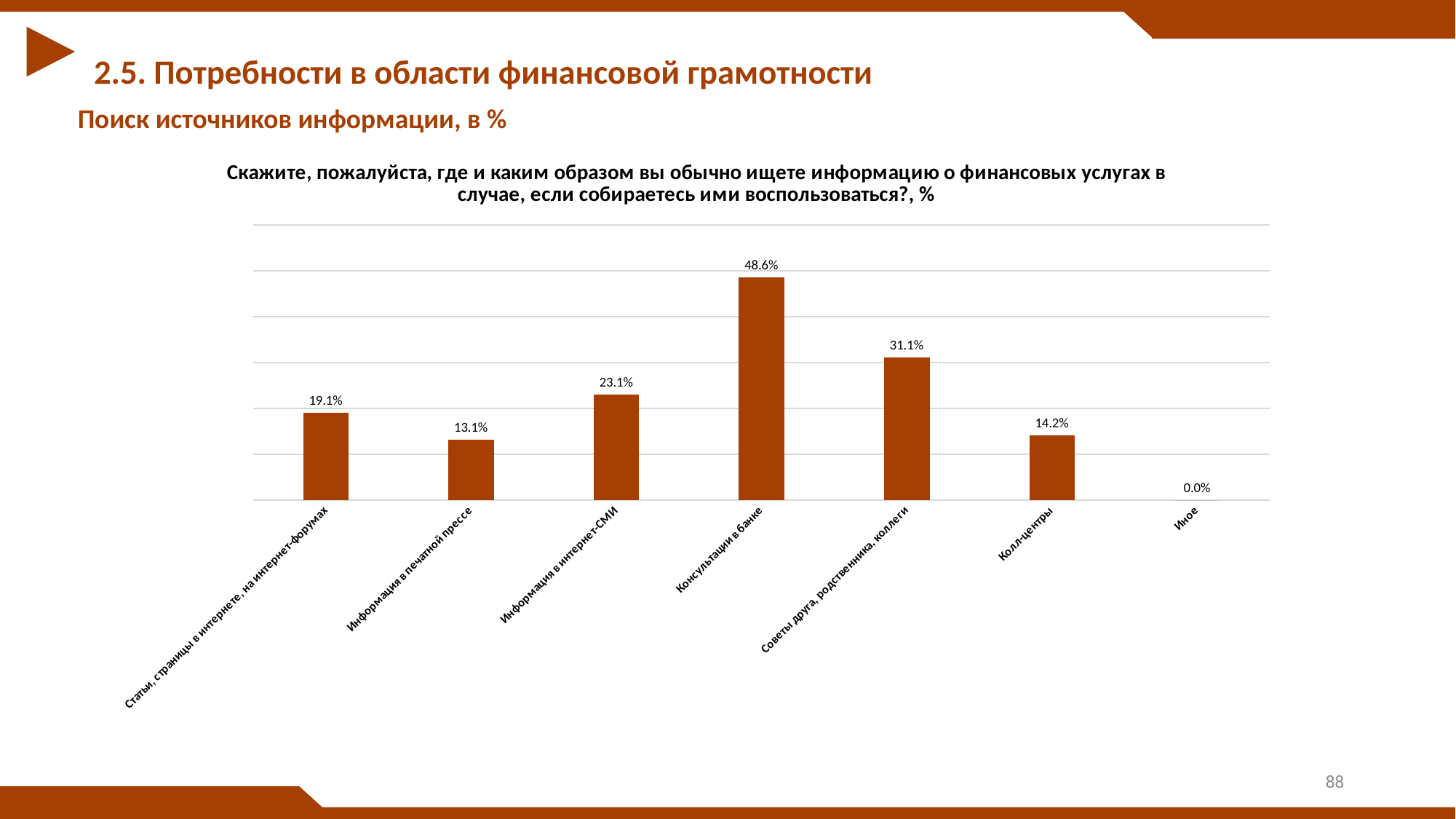
What is the value for «Консультации в банке»? 48.6% What is the difference between «Консультации в банке» and «Советы друга, родственника, коллеги»? 17.5% Which is larger: «Информация в интернет-СМИ» or «Колл-центры»? Информация в интернет-СМИ What is the value for «Советы друга, родственника, коллеги»? 31.1% What kind of chart is shown on the slide? Bar chart What is the value for «Информация в печатной прессе»? 13.1% What is the value for «Колл-центры»? 14.2% How many categories are shown in the chart? 7 What is the difference between «Информация в интернет-СМИ» and «Статьи, страницы в интернете, на интернет-форумах»? 4.0% Which category has the highest value? Консультации в банке Which category has the lowest value? Иное What is the value for «Иное»? 0.0%